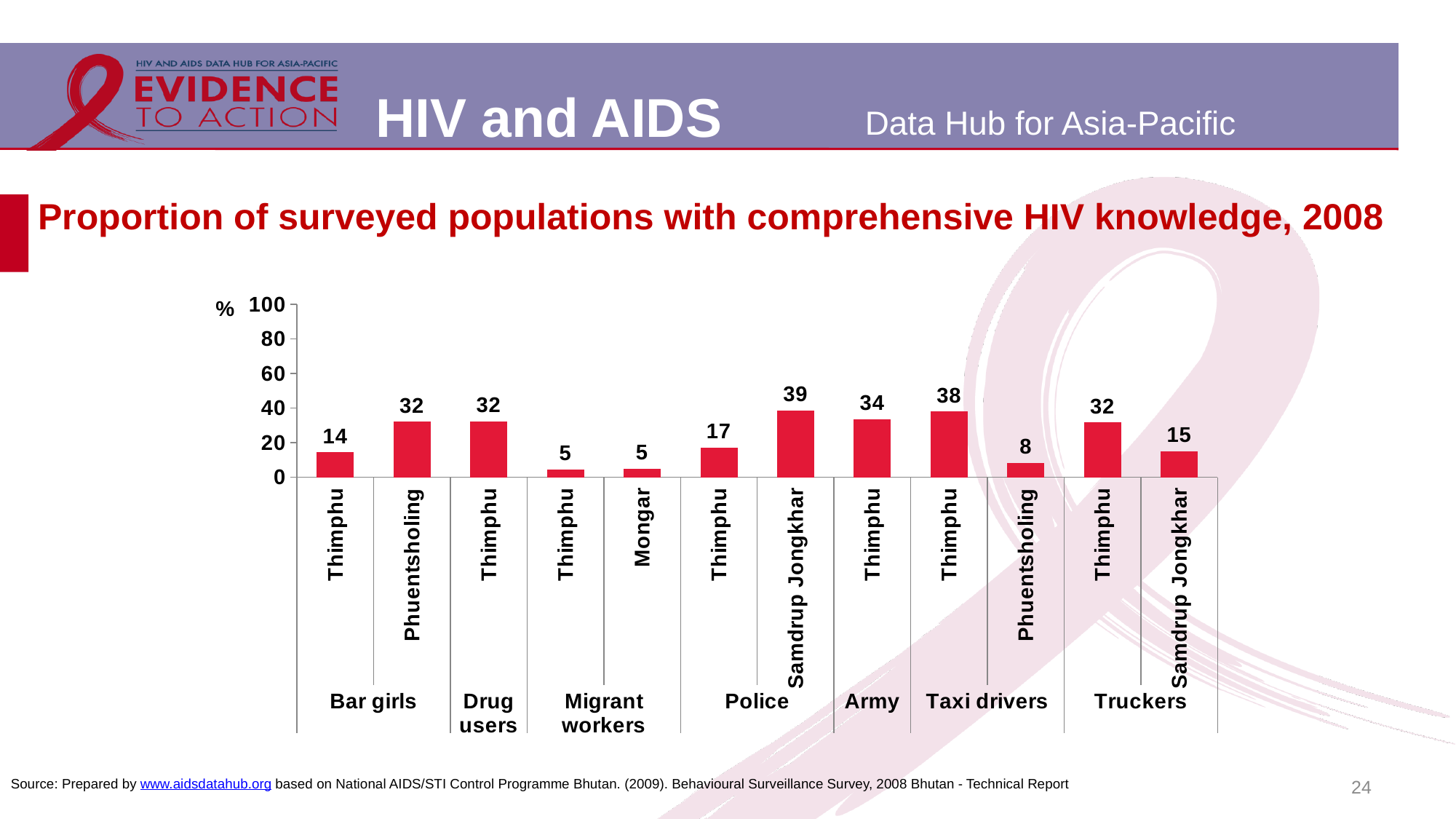
Which is larger: the value for army in Thimphu or taxi drivers in Thimphu? Taxi drivers in Thimphu What is the value for truckers in Samdrup Jongkhar? 15 What is the difference between the values for bar girls in Phuentsholing and bar girls in Thimphu? 18 What is the lowest value shown on the chart? 5 How many bars are plotted on the chart? 12 Is the value for police in Thimphu greater or less than 20? less What is the value for police in Samdrup Jongkhar? 39 What is the value for bar girls in Thimphu? 14 Which surveyed group and site has the highest value? Police, Samdrup Jongkhar What is the value for taxi drivers in Phuentsholing? 8 What is the maximum value shown on the vertical axis? 100 What kind of chart is shown on the slide? Bar chart